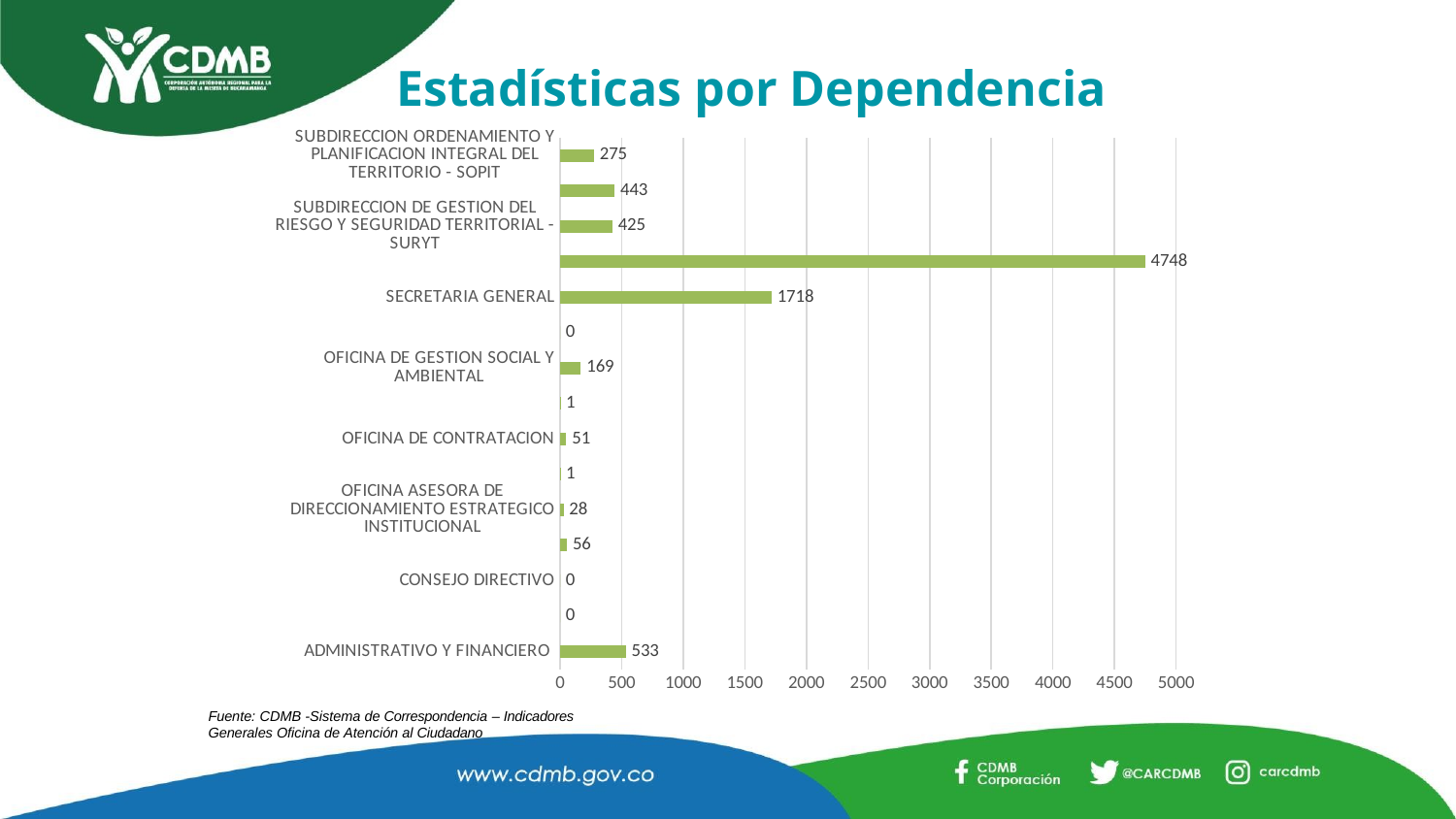
What is the value for CONSEJO DIRECTIVO? 0 How many bars are plotted in the chart? 15 What is the value for OFICINA DE GESTION SOCIAL Y AMBIENTAL? 169 What type of chart is shown on the slide? Bar chart What is the value for ADMINISTRATIVO Y FINANCIERO? 533 What is the title of the chart? Estadísticas por Dependencia What is the value for OFICINA DE CONTRATACION? 51 What is the largest value labelled on any bar in the chart? 4748 What is the value for SECRETARIA GENERAL? 1718 What is the difference between the values for SECRETARIA GENERAL and ADMINISTRATIVO Y FINANCIERO? 1185 Which has a larger value, SUBDIRECCION DE GESTION DEL RIESGO Y SEGURIDAD TERRITORIAL - SURYT or SUBDIRECCION ORDENAMIENTO Y PLANIFICACION INTEGRAL DEL TERRITORIO - SOPIT? SUBDIRECCION DE GESTION DEL RIESGO Y SEGURIDAD TERRITORIAL - SURYT Is the value for SECRETARIA GENERAL greater or less than 1500? greater